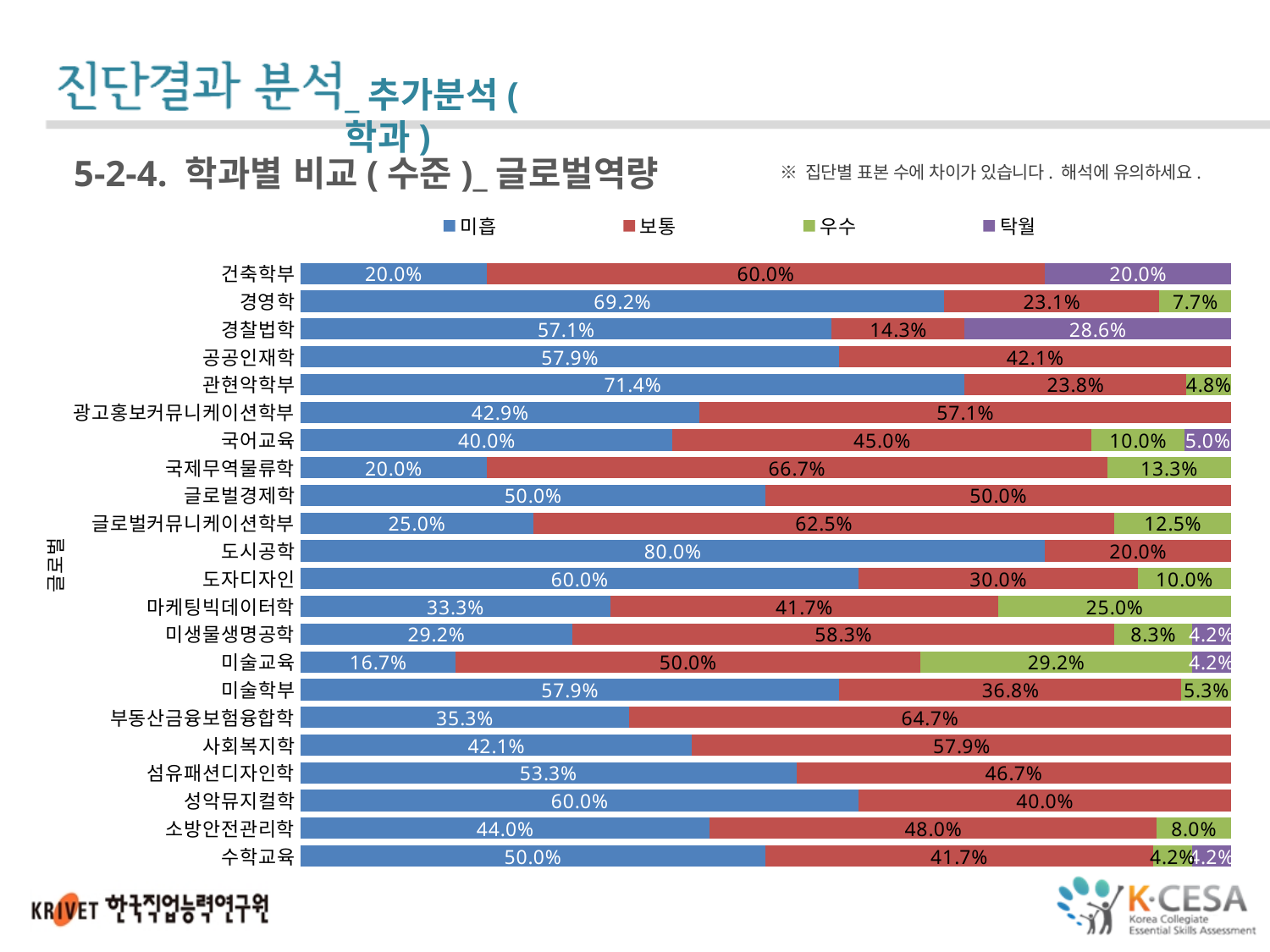
Which has a larger 보통 value, 부동산금융보험융합학 or 사회복지학? 부동산금융보험융합학 What are the four legend entries of the chart, in order? 미흡, 보통, 우수, 탁월 What type of chart is shown on the slide? stacked bar chart Which department has the highest 미흡 value? 도시공학 What is the difference between the 미흡 values of 경영학 and 건축학부? 49.2% What is the 우수 value for 마케팅빅데이터학? 25.0% How many departments (categories) are plotted in the chart? 22 Which department has the lowest 미흡 value? 미술교육 What is the 미흡 value for 도시공학? 80.0% What is the 탁월 value for 경찰법학? 28.6% What is the 보통 value for 국제무역물류학? 66.7% How many series does the legend list? 4